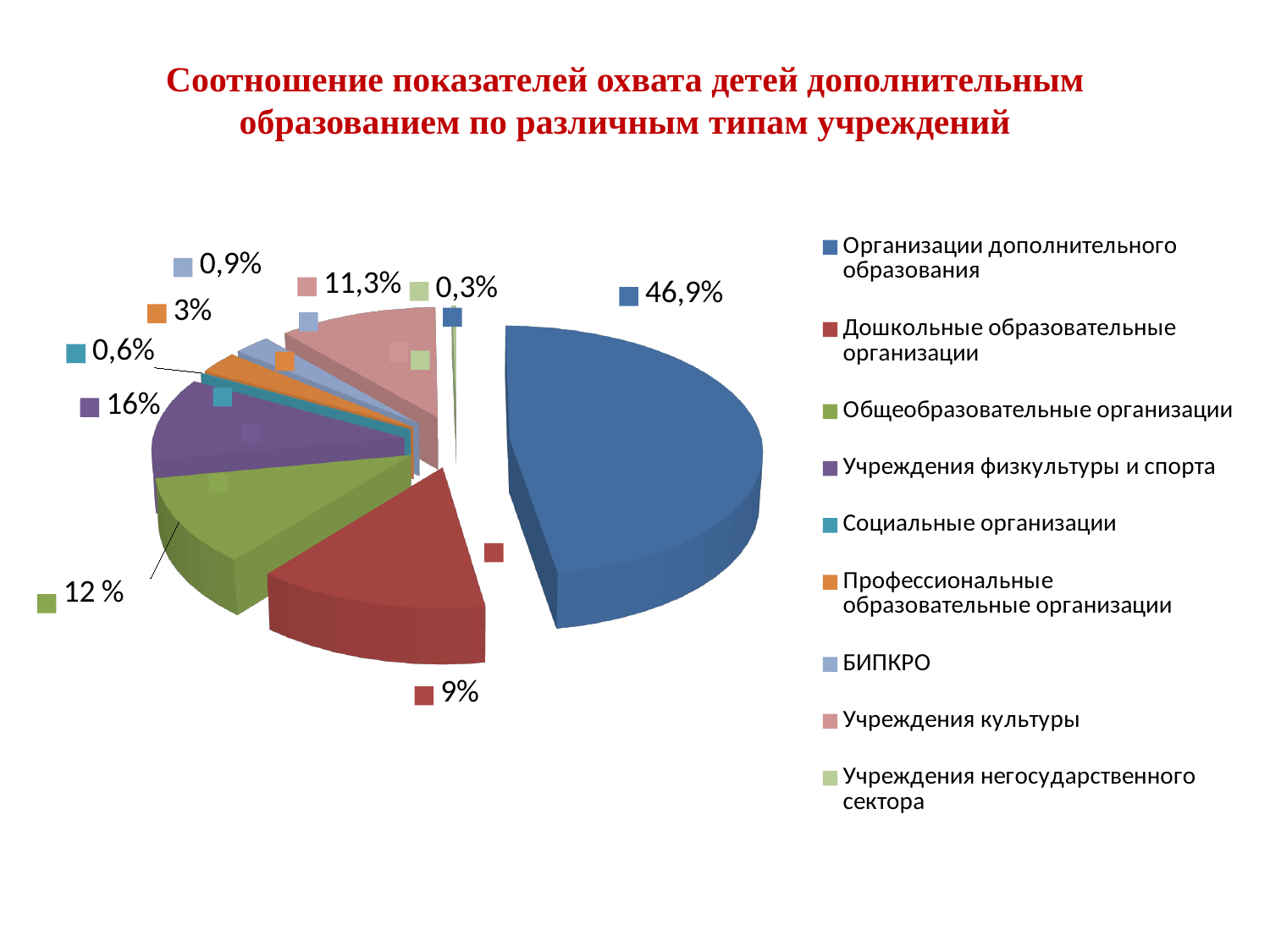
What value is shown for Дошкольные образовательные организации? 9% Which category has the largest share of the pie? Организации дополнительного образования What value is shown for Учреждения физкультуры и спорта? 16% Which category has the smallest share of the pie? Учреждения негосударственного сектора What value is shown for Учреждения негосударственного сектора? 0,3% What share of the pie is labelled for Организации дополнительного образования? 46,9% What is the difference between the shares for Учреждения физкультуры и спорта and Профессиональные образовательные организации? 13% What value is shown for Учреждения культуры? 11,3% What colour is the slice for БИПКРО? light blue What type of chart is shown on the slide? pie chart Which is larger: the share for Общеобразовательные организации or the share for Дошкольные образовательные организации? Общеобразовательные организации How many categories does the legend list? 9